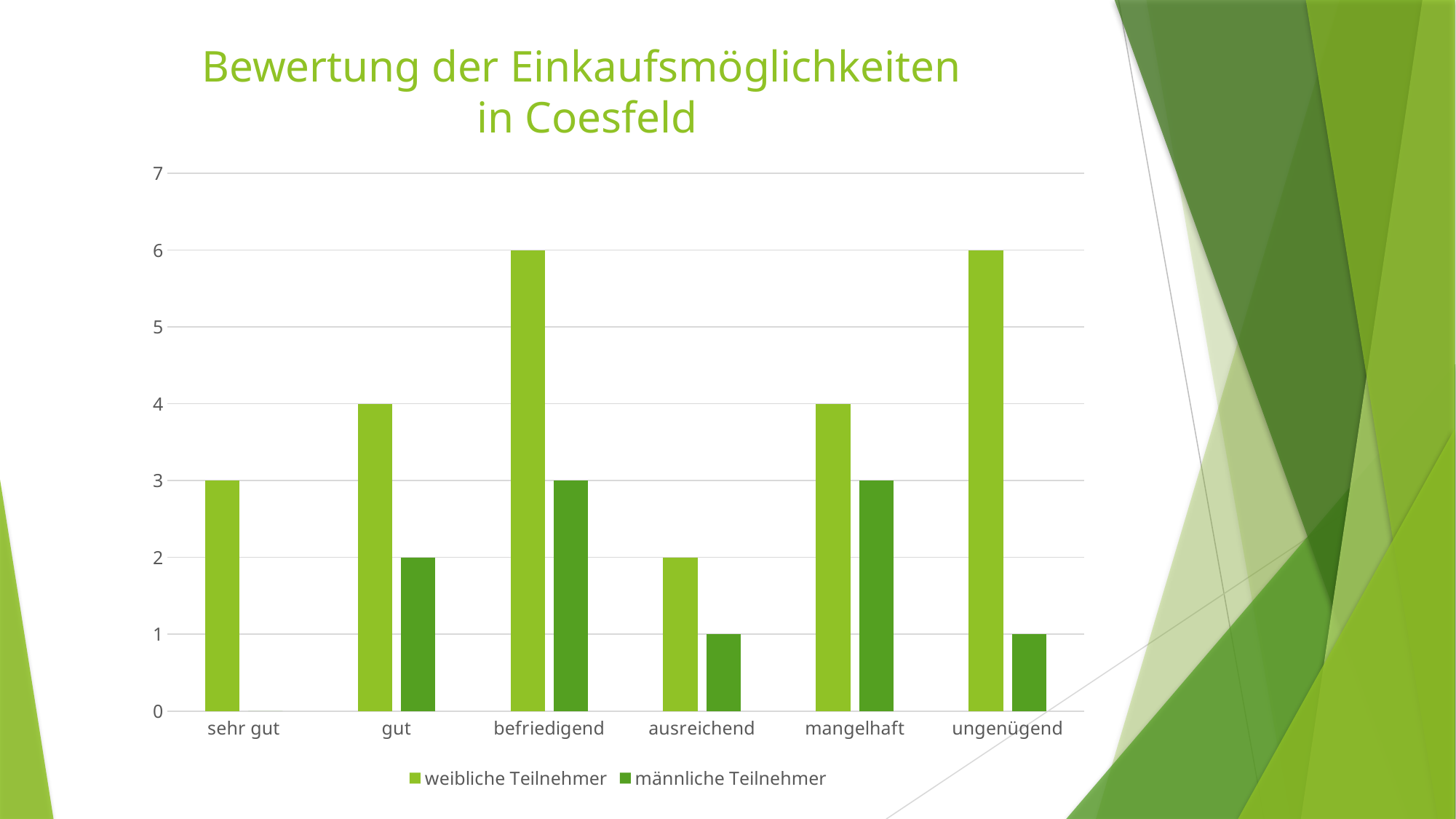
What is the title of the chart? Bewertung der Einkaufsmöglichkeiten in Coesfeld What is the value for männliche Teilnehmer in the category gut? 2 What kind of chart is shown on the slide? bar chart Which category has the lowest value for weibliche Teilnehmer? ausreichend How many series does the legend list? 2 How many categories are shown on the x axis? 6 Which is larger in the category mangelhaft: weibliche Teilnehmer or männliche Teilnehmer? weibliche Teilnehmer Is the value for weibliche Teilnehmer in the category gut greater or less than 3? greater What is the difference between weibliche Teilnehmer and männliche Teilnehmer in the category ungenügend? 5 What is the value for weibliche Teilnehmer in the category sehr gut? 3 What is the value for weibliche Teilnehmer in the category befriedigend? 6 What is the value for männliche Teilnehmer in the category mangelhaft? 3